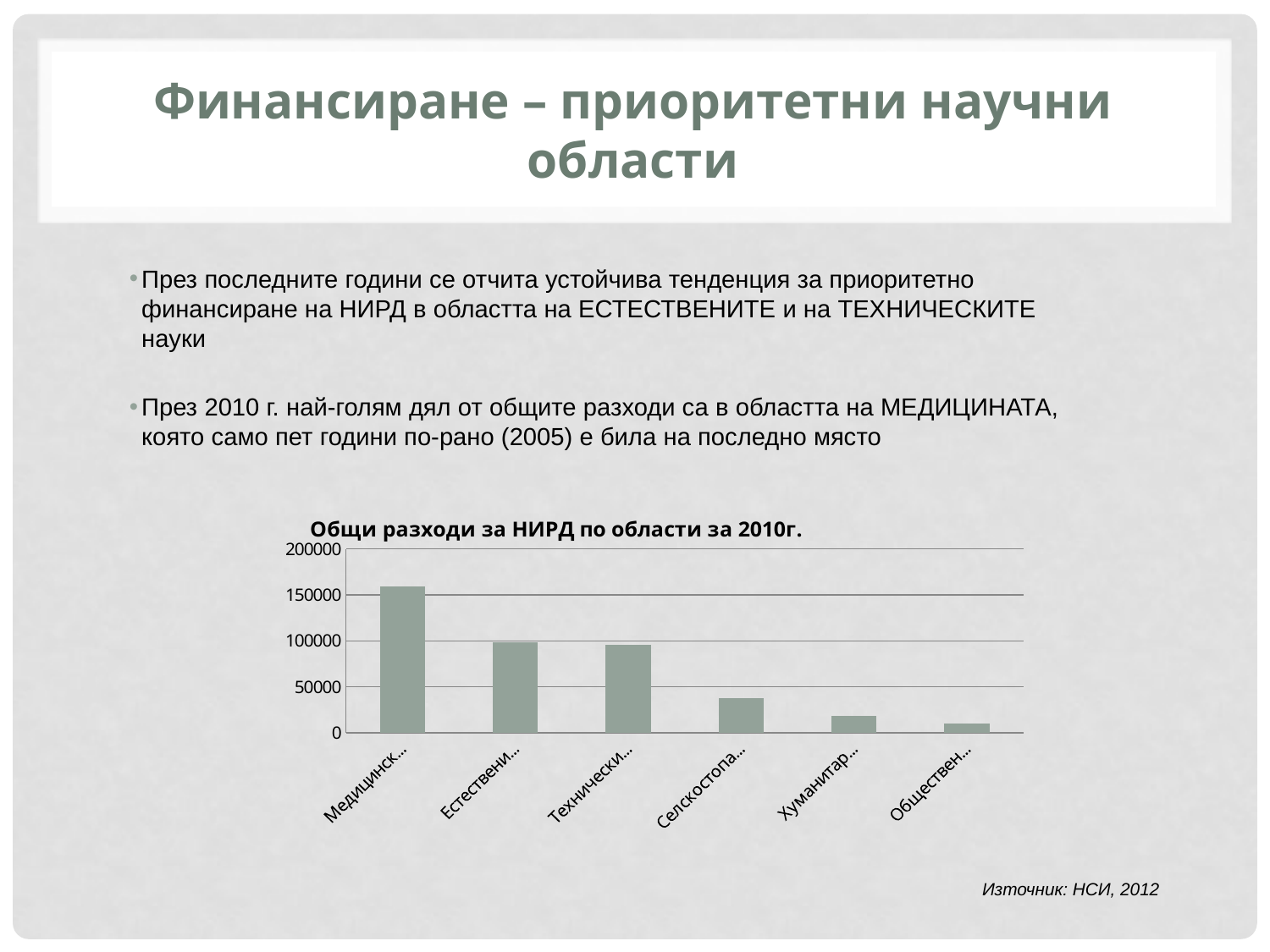
Which is larger, the value for Хуманитар... or the value for Обществен...? Хуманитар... How many categories (bars) does the chart show? 6 Which category has the lowest value in the chart? Обществен... Is the value for Медицинск... greater or less than 150000? greater Which category has the highest value in the chart? Медицинск... What is the title of the chart? Общи разходи за НИРД по области за 2010г. Do the values rise or fall from left to right along the x axis? fall What kind of chart is shown on the slide? bar chart Which is larger, the value for Медицинск... or the value for Селскостопа...? Медицинск... Is the value for Селскостопа... greater or less than 50000? less Is the value for Технически... greater or less than 50000? greater